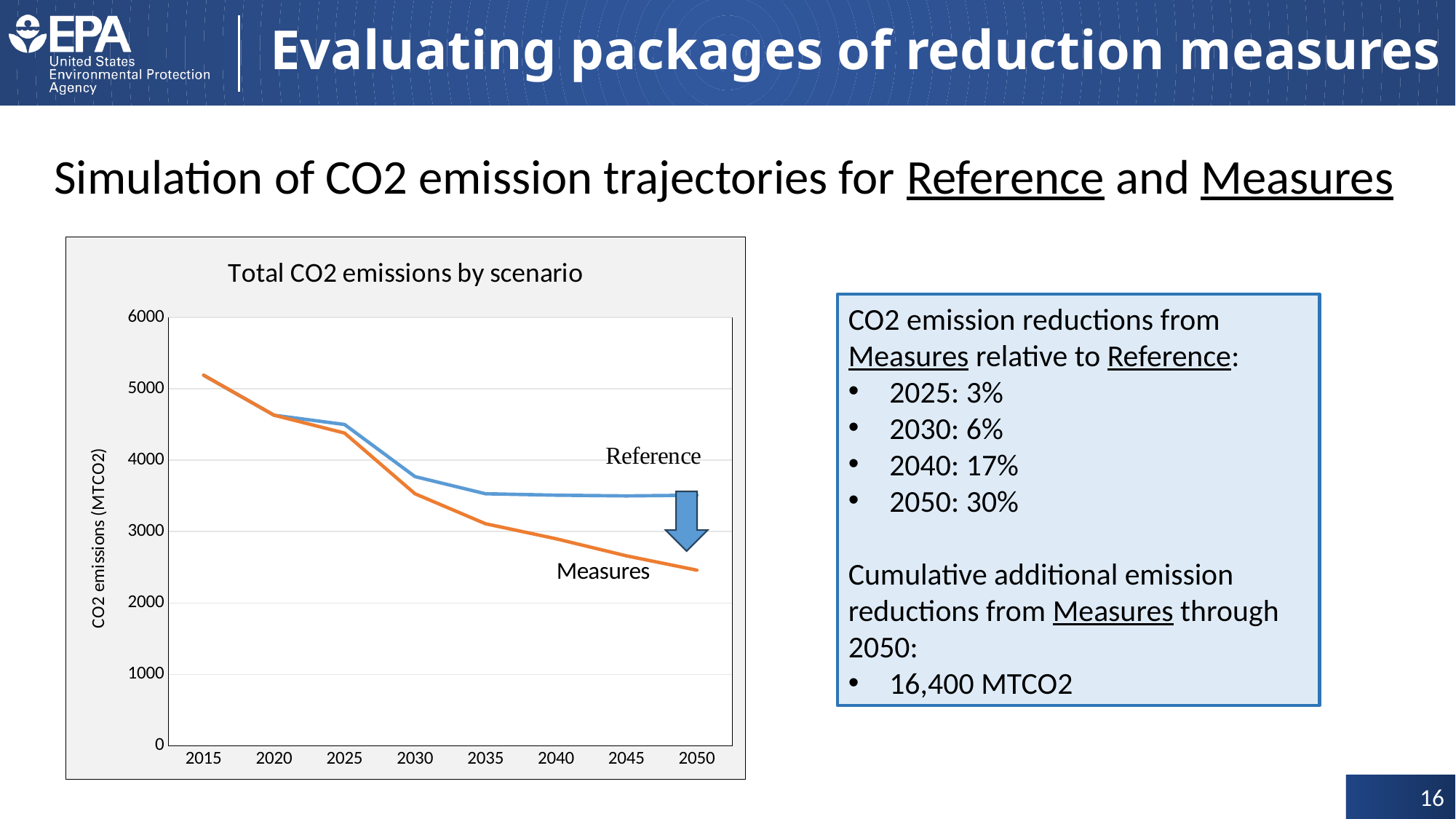
Is the value for the Reference scenario in 2015 greater or less than 5000? greater Do the CO2 emissions for the Measures scenario rise or fall from 2015 to 2050? fall Is the value for the Measures scenario in 2050 greater or less than 3000? less What is the title of the chart? Total CO2 emissions by scenario What kind of chart is shown on the slide? line chart In 2050, which scenario has higher CO2 emissions, Reference or Measures? Reference What is the label of the y axis of the chart? CO2 emissions (MTCO2) In which year does the Measures scenario have its lowest CO2 emissions? 2050 Is the value for the Reference scenario in 2025 greater or less than 4000? greater How many years are marked on the x axis of the chart? 8 How many scenario lines are plotted on the chart? 2